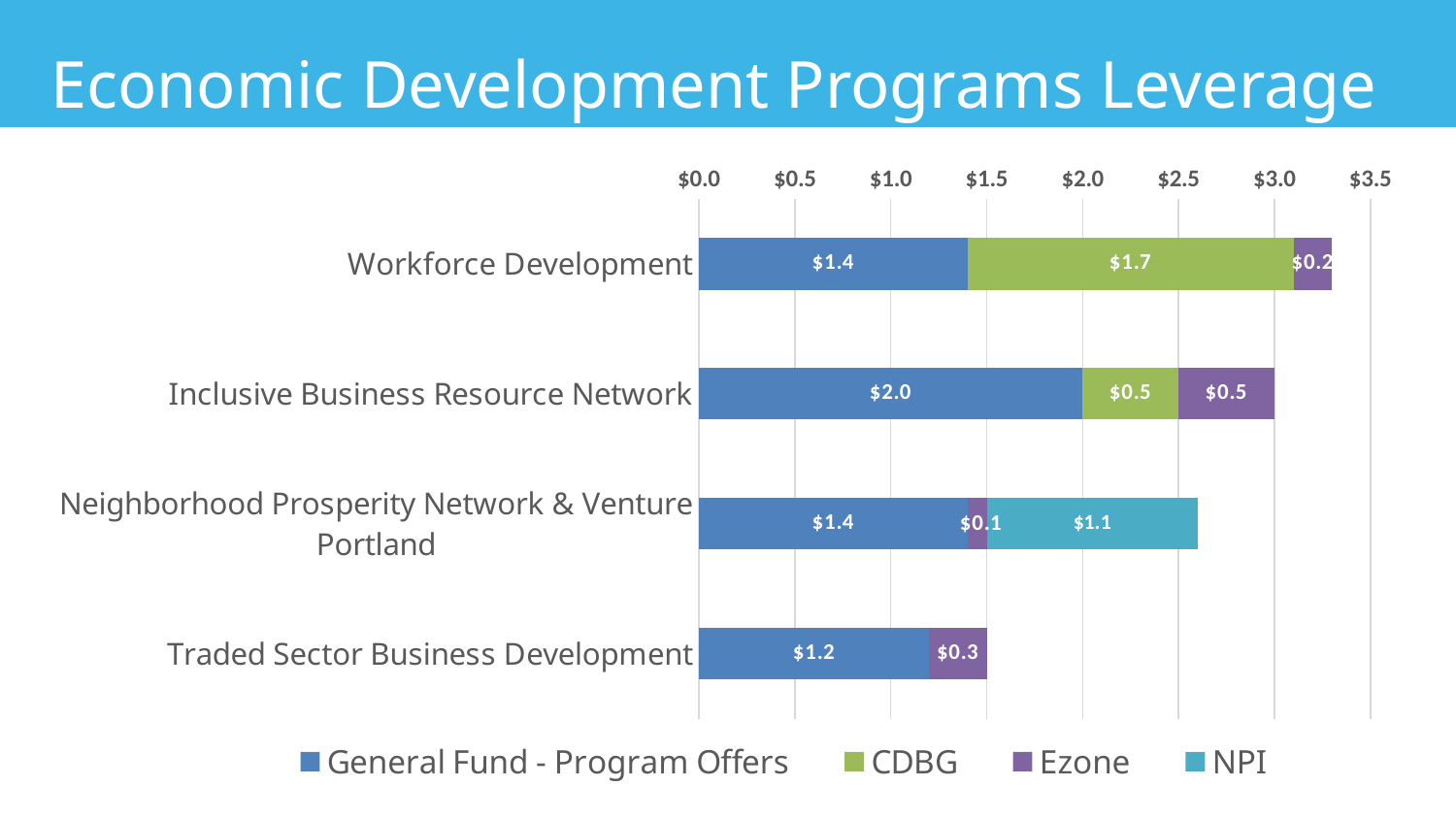
How many categories are shown on the chart? 4 What is the CDBG value for Workforce Development? $1.7 Which category has the lowest General Fund - Program Offers value? Traded Sector Business Development What is the total of the stacked bar for Traded Sector Business Development? $1.5 What is the General Fund - Program Offers value for Inclusive Business Resource Network? $2.0 What is the difference between the General Fund - Program Offers values for Inclusive Business Resource Network and Traded Sector Business Development? $0.8 Which is larger: the Ezone value for Inclusive Business Resource Network or the Ezone value for Workforce Development? Inclusive Business Resource Network What is the total of the stacked bar for Workforce Development? $3.3 What is the Ezone value for Traded Sector Business Development? $0.3 What is the NPI value for Neighborhood Prosperity Network & Venture Portland? $1.1 How many series does the legend list? 4 Which category has the highest General Fund - Program Offers value? Inclusive Business Resource Network